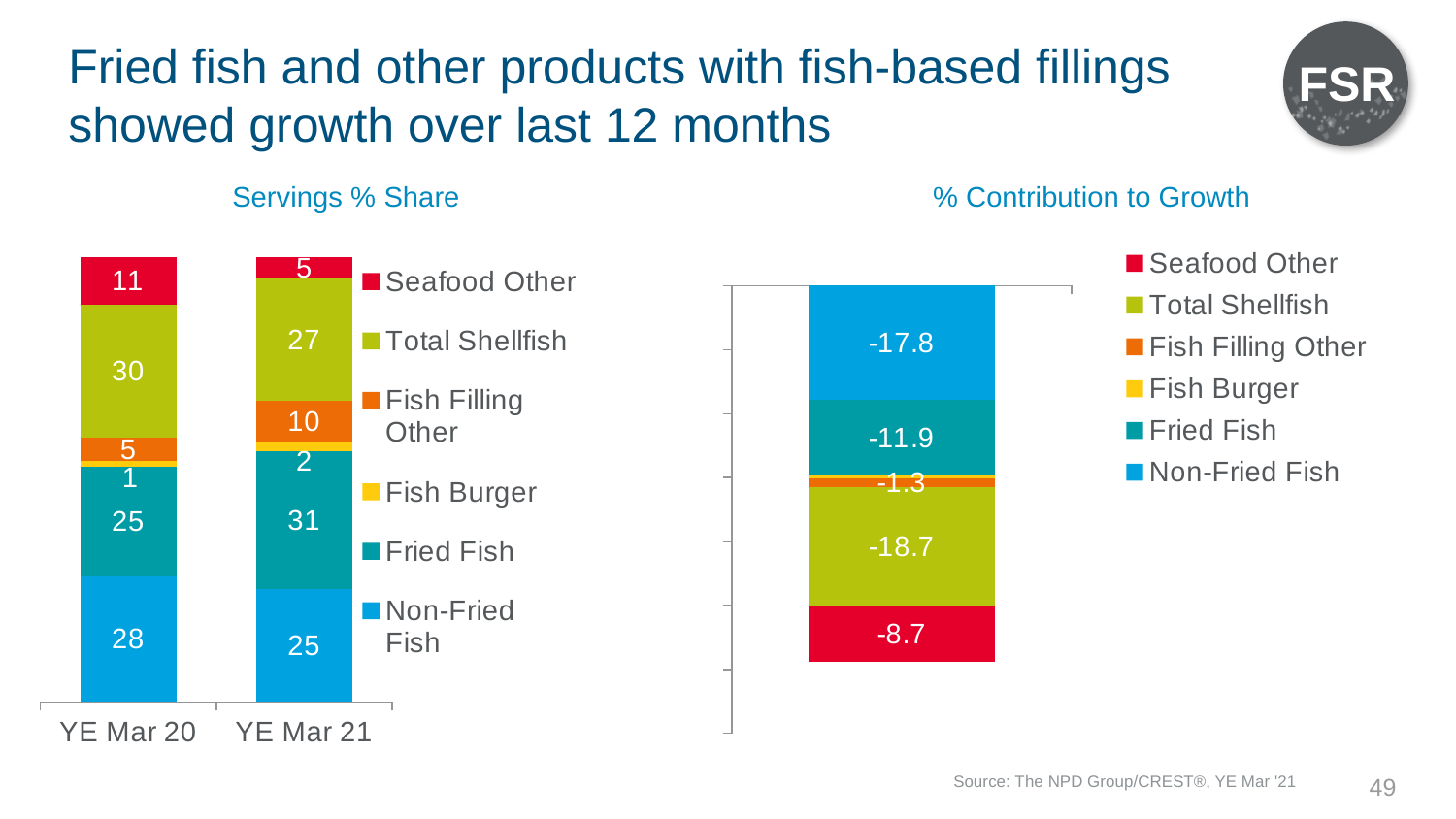
In the Servings % Share chart, what is the total of the YE Mar 20 stacked bar? 100 In the % Contribution to Growth chart, what is the value for Total Shellfish? -18.7 How many time periods are shown on the x axis of the Servings % Share chart? 2 In the % Contribution to Growth chart, what is the value for Non-Fried Fish? -17.8 In the Servings % Share chart, what is the value for Fried Fish in YE Mar 21? 31 What is the title of the chart on the right side of the slide? % Contribution to Growth In the % Contribution to Growth chart, which labelled series has the lowest (most negative) value? Total Shellfish In the Servings % Share chart, what is the value for Non-Fried Fish in YE Mar 20? 28 In the Servings % Share chart, is Total Shellfish larger in YE Mar 20 or YE Mar 21? YE Mar 20 What kind of chart is the Servings % Share chart? Stacked bar chart In the Servings % Share chart, by how much did Fish Filling Other increase from YE Mar 20 to YE Mar 21? 5 How many series does the legend of the Servings % Share chart list? 6